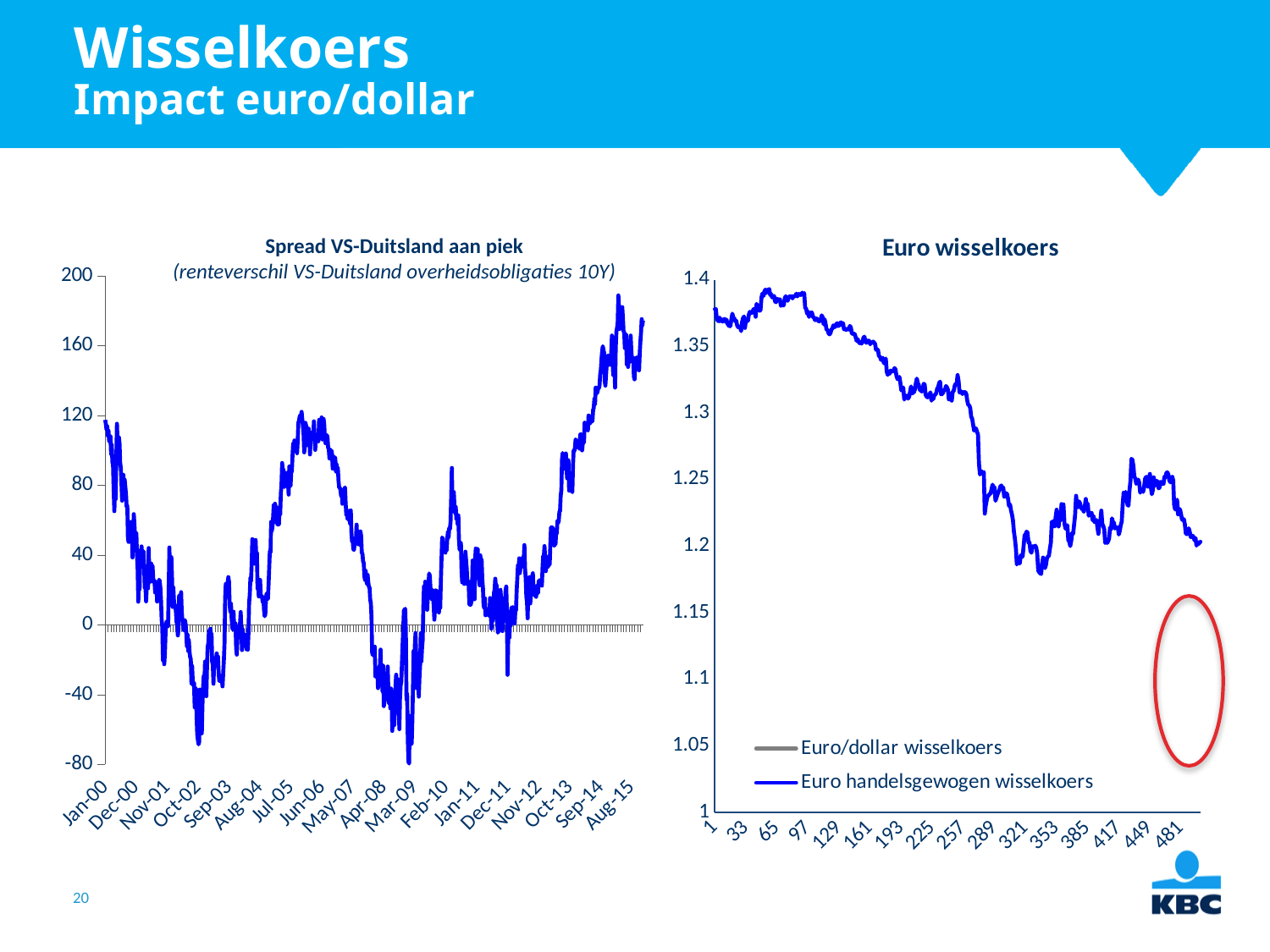
In the right chart 'Euro wisselkoers', is the value at the end of the series (around x = 481) greater or less than 1.25? less In the right chart 'Euro wisselkoers', what are the two legend entries? Euro/dollar wisselkoers; Euro handelsgewogen wisselkoers In the left chart 'Spread VS-Duitsland aan piek', is the value at Jan-00 greater or less than 80? greater In the left chart 'Spread VS-Duitsland aan piek', is the value around Mar-09 greater or less than 0? less In the right chart 'Euro wisselkoers', how many series does the legend list? 2 What kind of chart is the right chart titled 'Euro wisselkoers'? line chart In the left chart 'Spread VS-Duitsland aan piek', does the line rise or fall between Nov-12 and Aug-15? rise What is the subtitle shown in italics under the left chart's title? (renteverschil VS-Duitsland overheidsobligaties 10Y) In the right chart 'Euro wisselkoers', does the line overall rise or fall from left to right? fall What kind of chart is the left chart titled 'Spread VS-Duitsland aan piek'? line chart